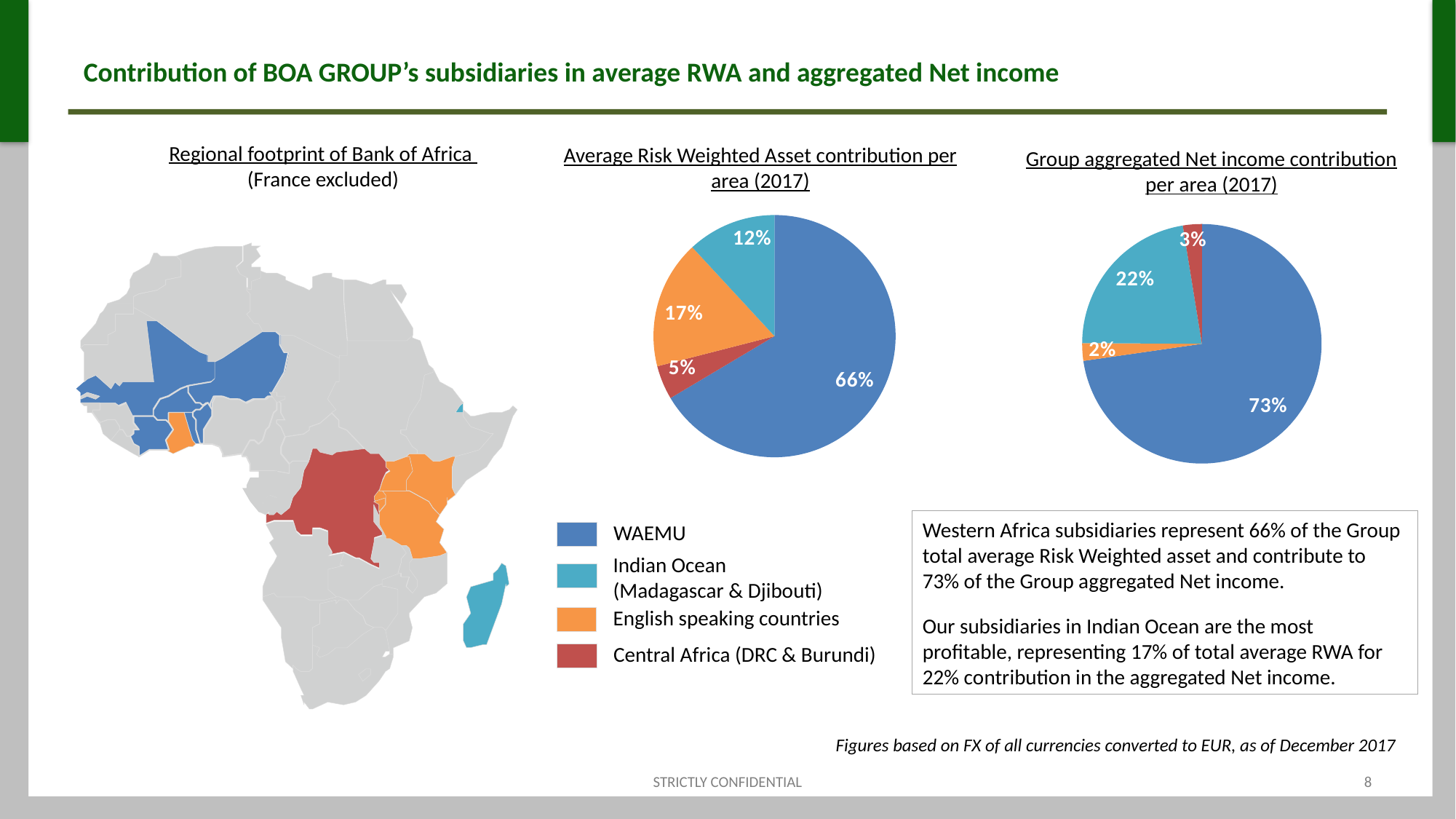
In the 'Group aggregated Net income contribution per area (2017)' pie chart, what share is shown for English speaking countries? 2% How many areas does the shared legend for the pie charts list? 4 In the 'Group aggregated Net income contribution per area (2017)' pie chart, what share is shown for WAEMU? 73% In the 'Average Risk Weighted Asset contribution per area (2017)' pie chart, what share is shown for Central Africa (DRC & Burundi)? 5% In the 'Group aggregated Net income contribution per area (2017)' pie chart, which area has the smallest slice? English speaking countries By how many percentage points is WAEMU's share in the 'Group aggregated Net income contribution per area (2017)' chart higher than its share in the 'Average Risk Weighted Asset contribution per area (2017)' chart? 7 percentage points What type of chart is used to show the Average Risk Weighted Asset contribution per area (2017)? Pie chart In the 'Group aggregated Net income contribution per area (2017)' pie chart, what share is shown for Central Africa (DRC & Burundi)? 3% Is Central Africa's share larger in the 'Average Risk Weighted Asset contribution per area (2017)' chart or in the 'Group aggregated Net income contribution per area (2017)' chart? Average Risk Weighted Asset contribution per area (2017) In the 'Group aggregated Net income contribution per area (2017)' pie chart, what share is shown for Indian Ocean (Madagascar & Djibouti)? 22% In the 'Average Risk Weighted Asset contribution per area (2017)' pie chart, which area has the largest slice? WAEMU In the 'Average Risk Weighted Asset contribution per area (2017)' pie chart, what share is shown for WAEMU? 66%